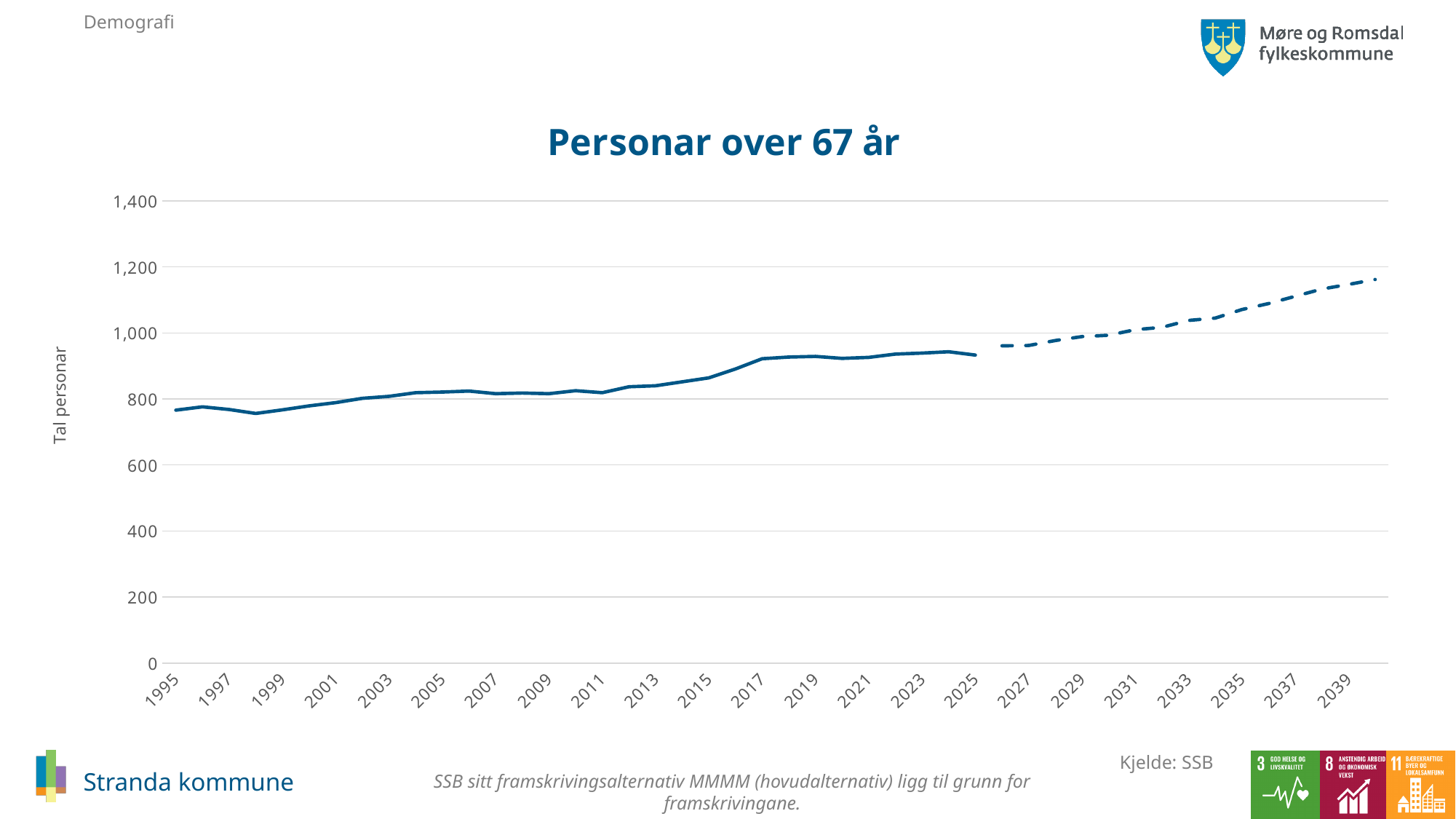
Is the value for 1995 greater or less than 800? less Which year has the larger value, 2011 or 2017? 2017 Is the value for 2035 greater or less than 1,000? greater Do the values generally rise or fall from 1995 to 2039? rise How many year labels are shown on the x axis? 23 Is the value for 1999 greater or less than 800? less What is the title of the chart? Personar over 67 år What kind of chart is shown on the slide? line chart What is the label on the vertical axis of the chart? Tal personar